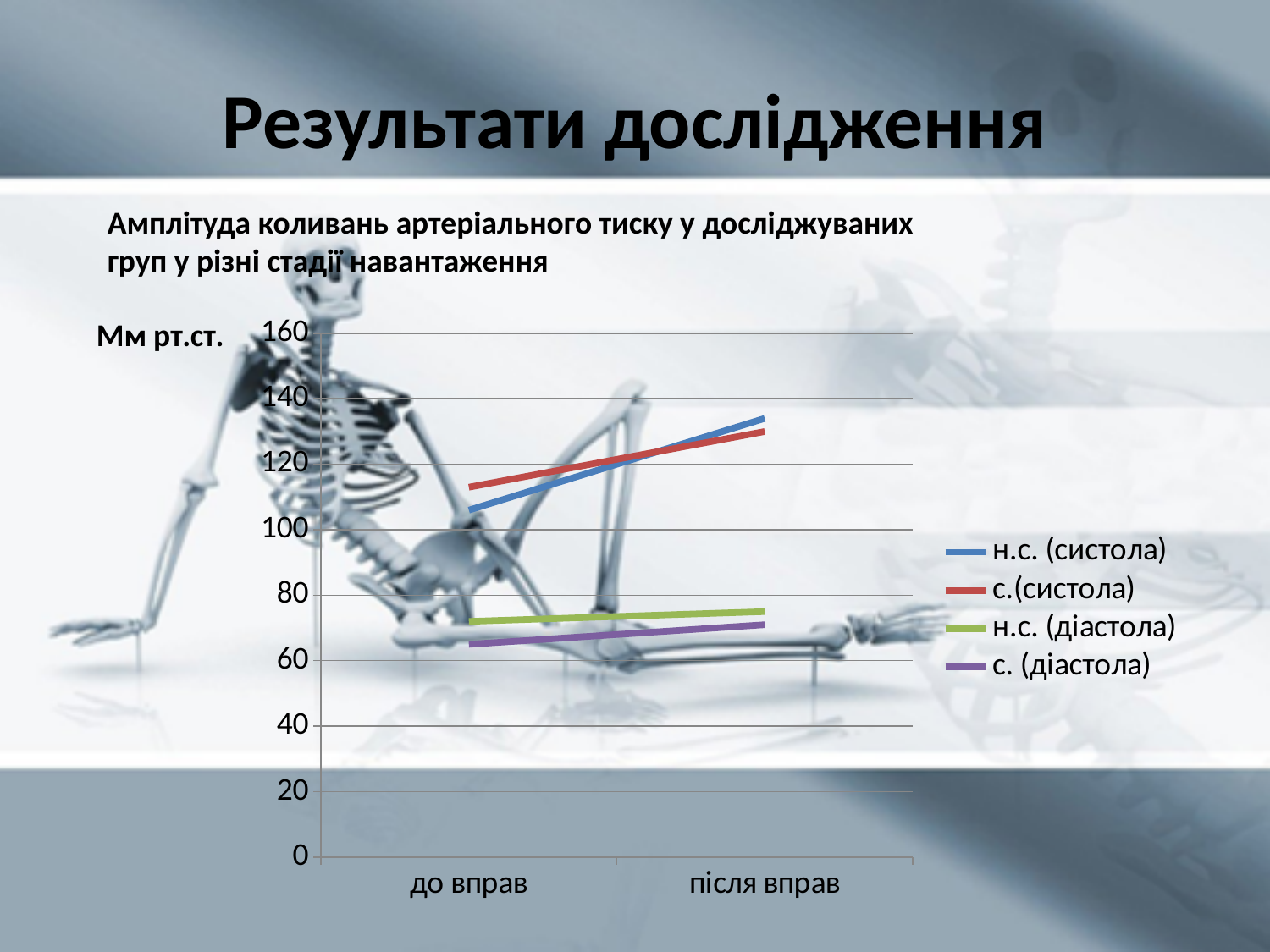
What unit is shown on the y axis label? Мм рт.ст. Which series has the lowest value at до вправ? с. (діастола) Does the value for н.с. (систола) rise or fall from до вправ to після вправ? rise Is the value for н.с. (діастола) at до вправ greater or less than 80? less Does the value for с. (діастола) rise or fall from до вправ to після вправ? rise At до вправ, which is larger: н.с. (діастола) or с. (діастола)? н.с. (діастола) Is the value for н.с. (систола) at після вправ greater or less than 120? greater How many series does the legend list? 4 How many categories are shown on the x axis? 2 Which series has the highest value at після вправ? н.с. (систола) Is the value for с.(систола) at до вправ greater or less than 120? less What kind of chart is shown on the slide? line chart